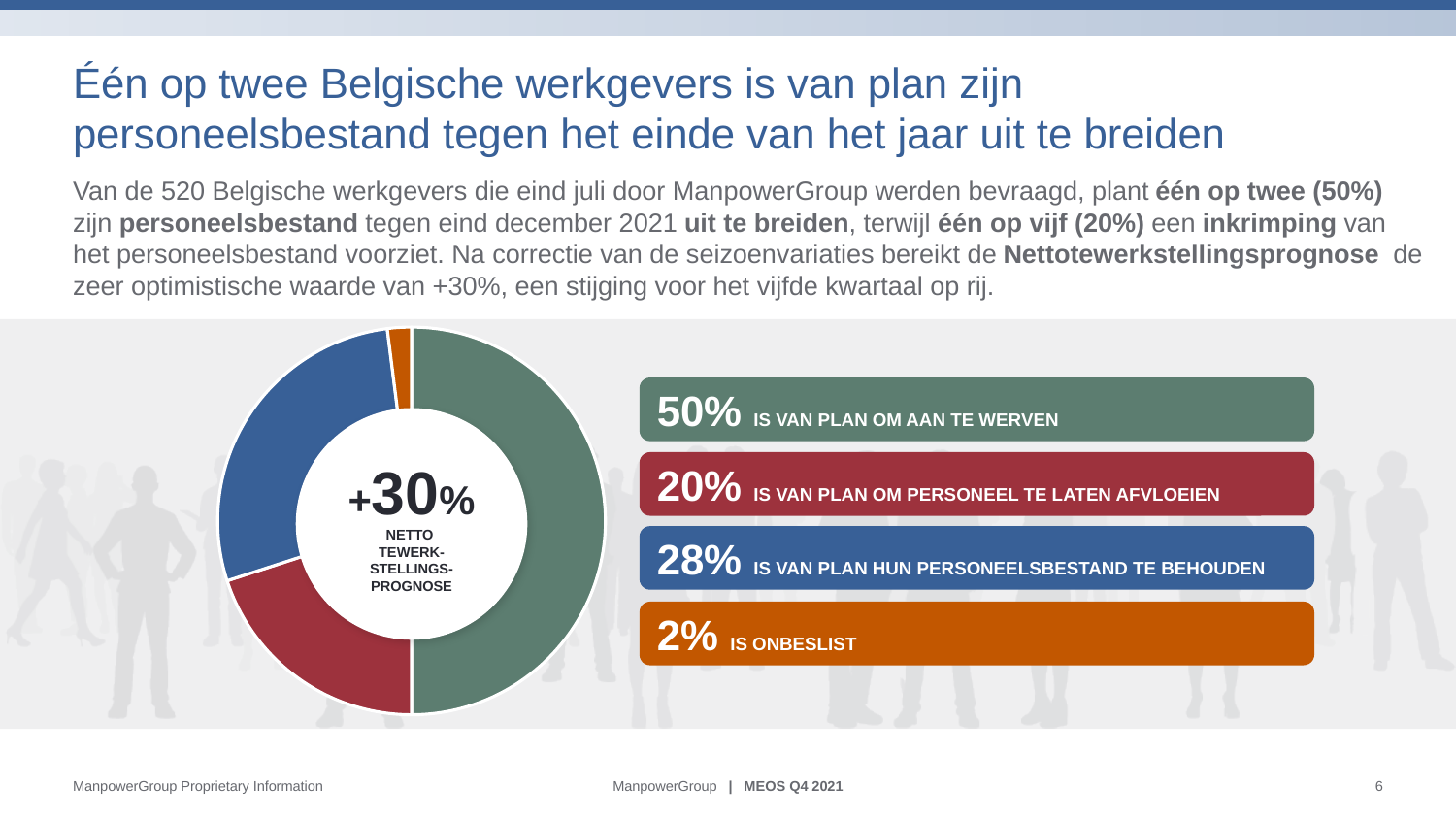
What share of employers is undecided ("is onbeslist")? 2% What share of employers plan to let staff go ("is van plan om personeel te laten afvloeien")? 20% What is the difference between the share planning to hire and the share planning to let staff go? 30 percentage points Which category has the largest share of the donut chart? Is van plan om aan te werven (50%) What colour is the slice representing employers who plan to hire? Green What value is shown in the centre of the donut chart? +30% What kind of chart is shown on the slide? Pie (donut) chart Which category has the smallest share of the donut chart? Is onbeslist (2%) Which is larger: the share planning to keep their workforce or the share planning to let staff go? Keep their workforce (28%) What share of Belgian employers plan to hire ("is van plan om aan te werven")? 50% What share of employers plan to keep their workforce unchanged ("is van plan hun personeelsbestand te behouden")? 28% How many slices does the donut chart have? 4